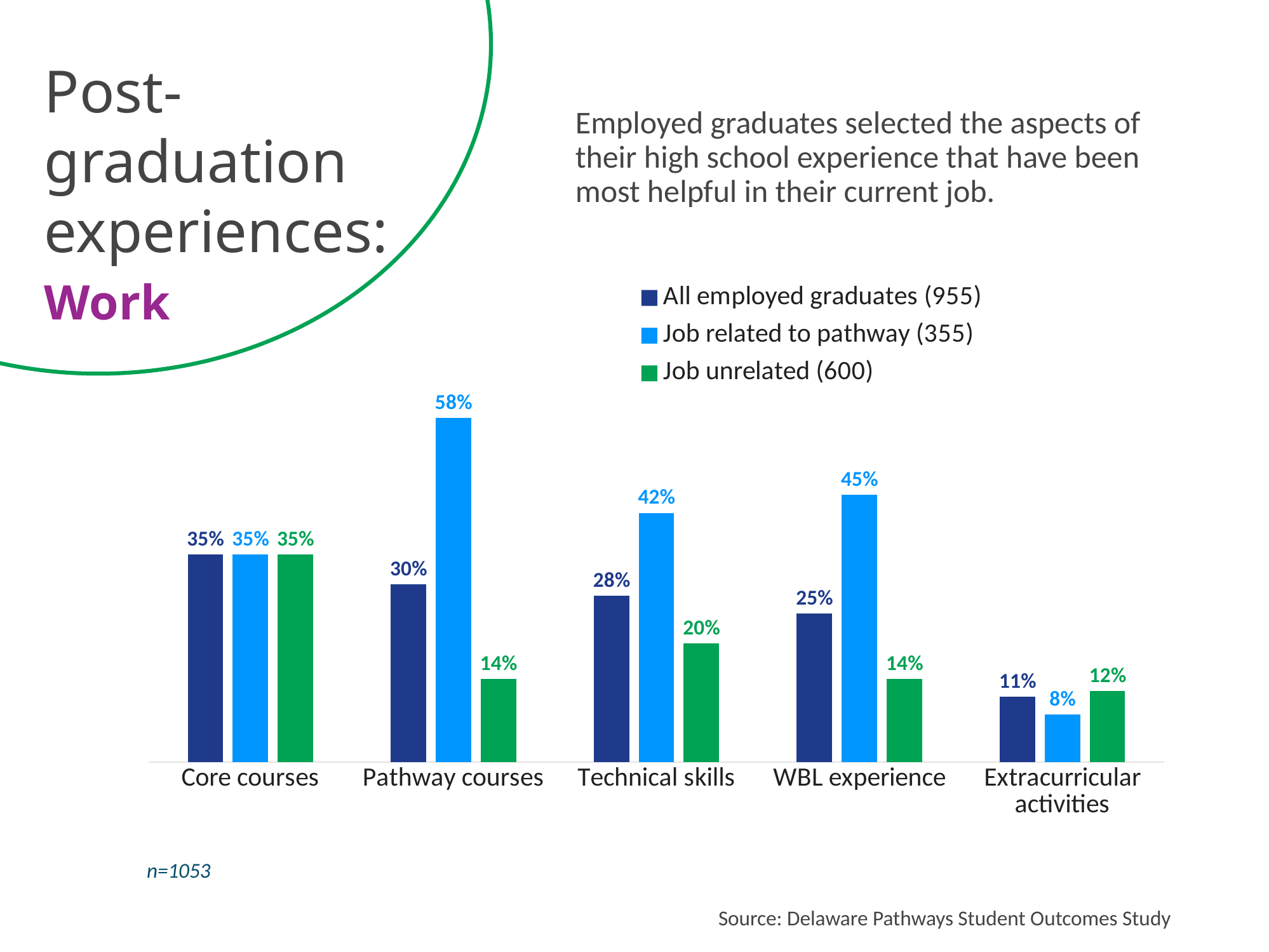
Which category has the lowest value for the 'All employed graduates (955)' series? Extracurricular activities Which category has the highest value for the 'Job related to pathway (355)' series? Pathway courses What colour represents the 'Job unrelated (600)' series? Green What is the value for 'Job unrelated (600)' for Technical skills? 20% What kind of chart is shown on the slide? Bar chart What is the value for 'All employed graduates (955)' for WBL experience? 25% How many categories are shown on the x axis? 5 How many series does the legend list? 3 What is the difference between the 'Job related to pathway (355)' and 'Job unrelated (600)' values for Pathway courses? 44% For Extracurricular activities, which is larger: the 'Job unrelated (600)' value or the 'Job related to pathway (355)' value? Job unrelated (600) Do the values for 'All employed graduates (955)' rise or fall from Core courses to Extracurricular activities? Fall What percentage of the 'Job related to pathway (355)' group selected Pathway courses? 58%